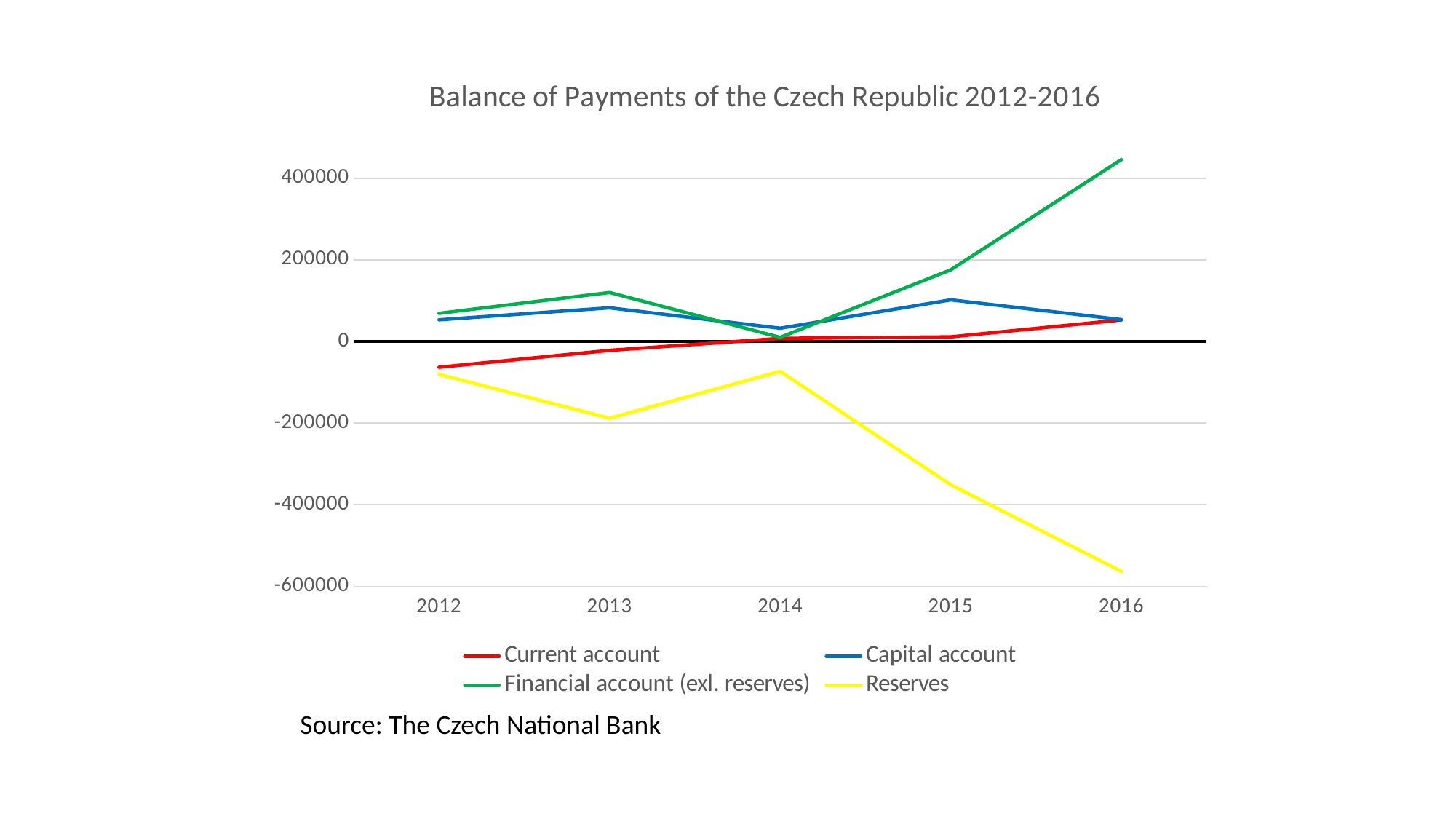
Is the value for Current account in 2012 greater or less than 0? less Do the Reserves values rise or fall from 2014 to 2016? fall In 2016, which is larger: Financial account (exl. reserves) or Capital account? Financial account (exl. reserves) Which series is drawn in yellow? Reserves Is the value for Financial account (exl. reserves) in 2016 greater or less than 400000? greater What is the title of the chart? Balance of Payments of the Czech Republic 2012-2016 In which year is the Financial account (exl. reserves) value highest? 2016 Is the value for Reserves in 2016 greater or less than -400000? less What kind of chart is shown on the slide? line chart How many series does the legend list? 4 How many years are plotted along the x axis? 5 In which year is the Reserves value lowest? 2016